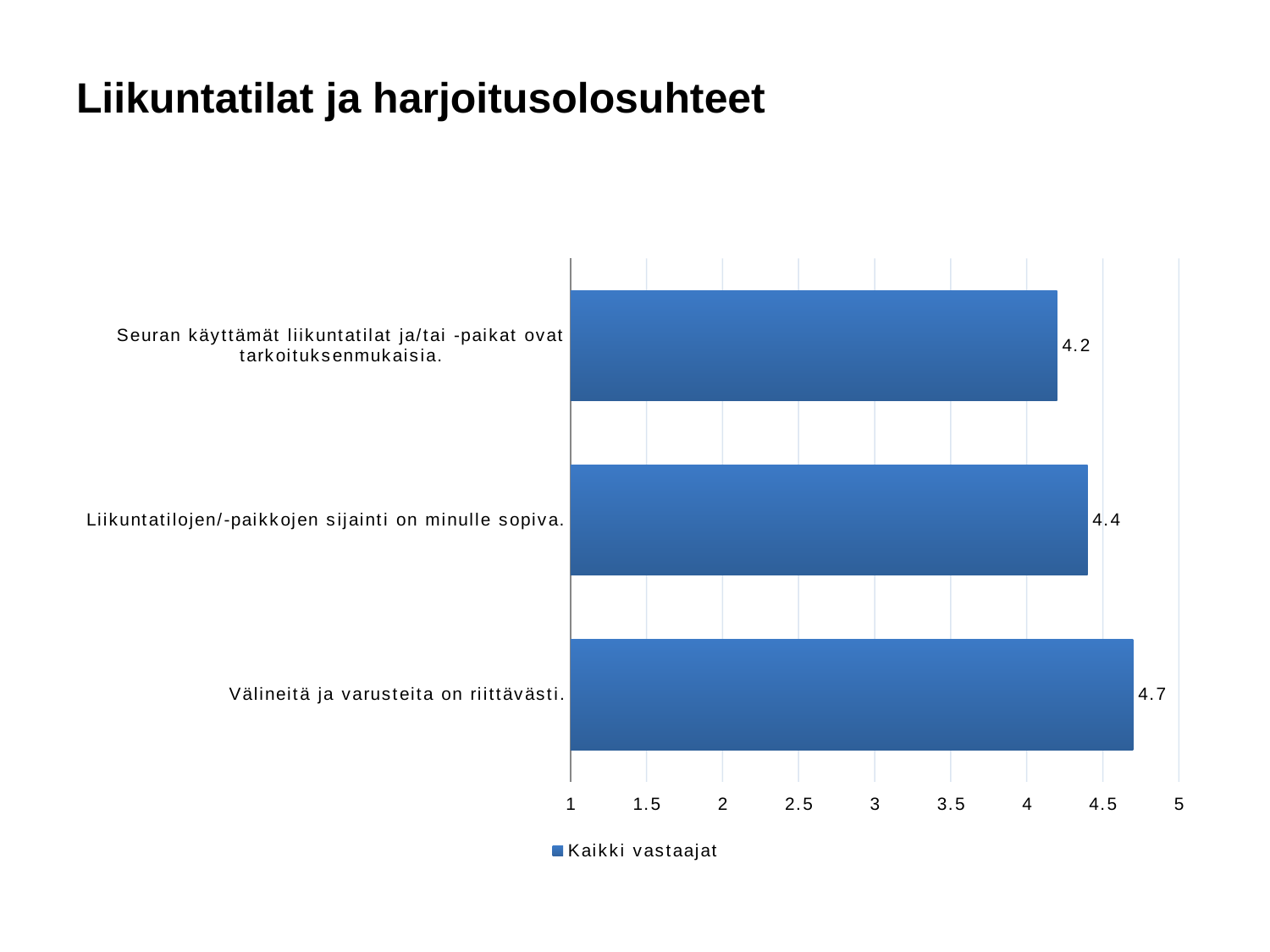
Is the value for "Seuran käyttämät liikuntatilat ja/tai -paikat ovat tarkoituksenmukaisia." greater or less than 4.5? less How many categories are shown in the chart? 3 Which category has the lowest value? Seuran käyttämät liikuntatilat ja/tai -paikat ovat tarkoituksenmukaisia. What is the value for "Liikuntatilojen/-paikkojen sijainti on minulle sopiva."? 4.4 How many series does the legend list? 1 Which is larger: the value for "Liikuntatilojen/-paikkojen sijainti on minulle sopiva." or for "Välineitä ja varusteita on riittävästi."? Välineitä ja varusteita on riittävästi. What is the difference between the values for "Liikuntatilojen/-paikkojen sijainti on minulle sopiva." and "Seuran käyttämät liikuntatilat ja/tai -paikat ovat tarkoituksenmukaisia."? 0.2 Which category has the highest value? Välineitä ja varusteita on riittävästi. What is the value for "Seuran käyttämät liikuntatilat ja/tai -paikat ovat tarkoituksenmukaisia."? 4.2 What is the value for "Välineitä ja varusteita on riittävästi."? 4.7 What kind of chart is shown on the slide? bar chart What is the difference between the values for "Välineitä ja varusteita on riittävästi." and "Seuran käyttämät liikuntatilat ja/tai -paikat ovat tarkoituksenmukaisia."? 0.5